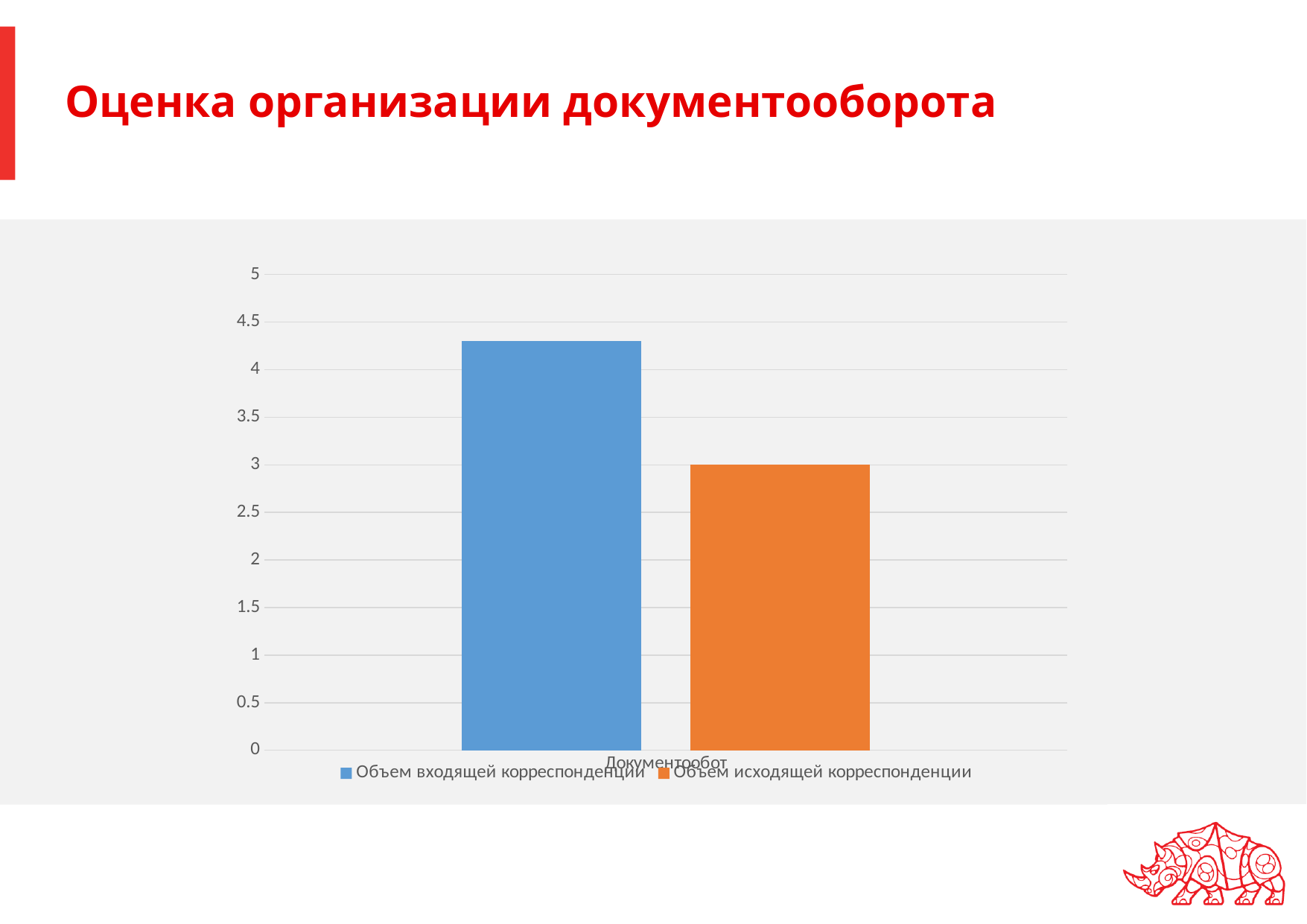
How many series does the legend list? 2 What colour is the bar for Объем входящей корреспонденции? blue What kind of chart is shown on the slide? bar chart Which series has the higher value: Объем входящей корреспонденции or Объем исходящей корреспонденции? Объем входящей корреспонденции Is the value for Объем исходящей корреспонденции greater or less than 2.5? greater What is the category label shown on the x axis? Документообот How many categories are plotted on the x axis? 1 Which series has the highest bar? Объем входящей корреспонденции What is the value for Объем исходящей корреспонденции? 3 Which series has the lowest bar? Объем исходящей корреспонденции Is the value for Объем входящей корреспонденции greater or less than 4? greater Is the value for Объем входящей корреспонденции greater or less than 4.5? less